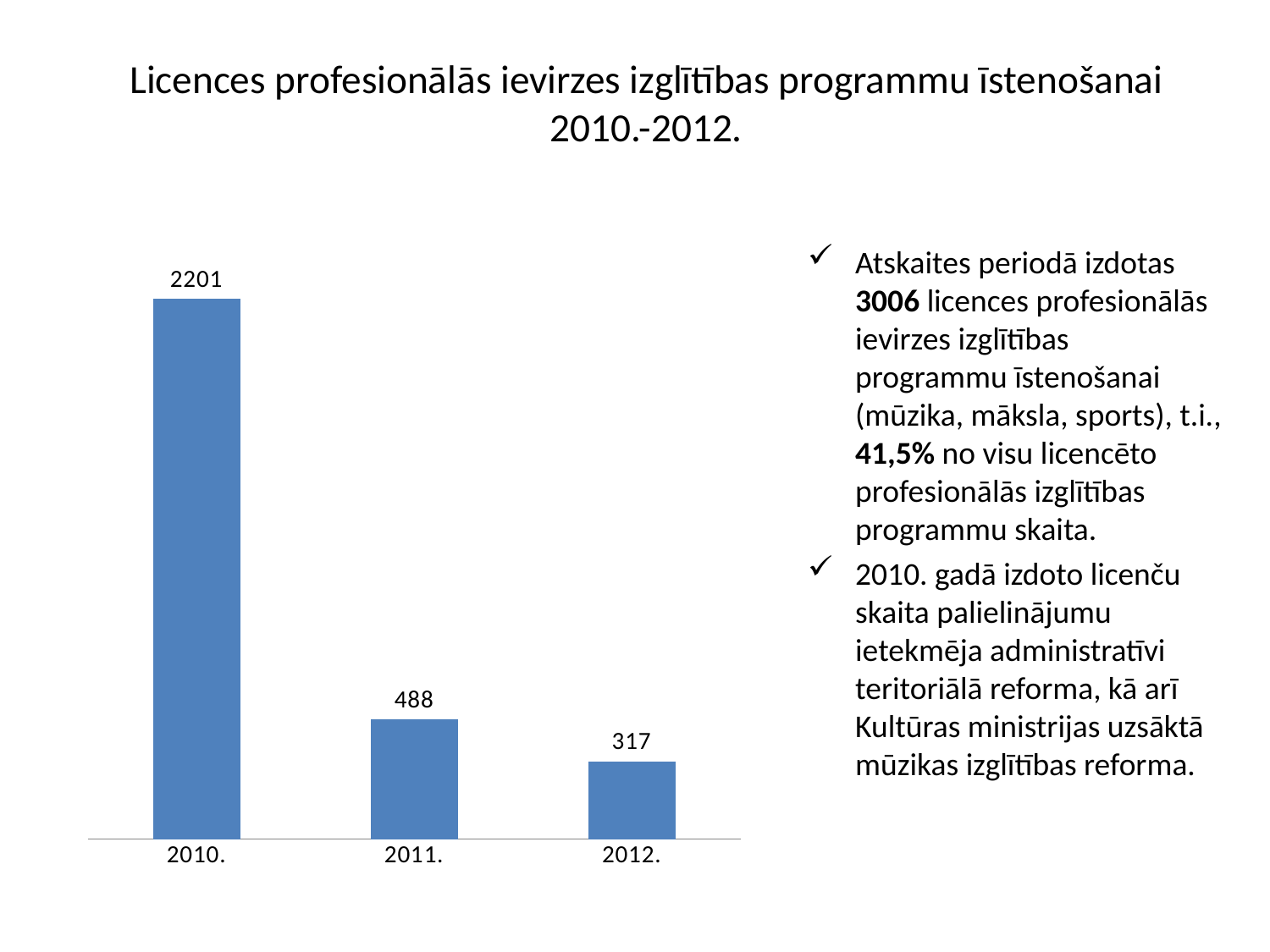
What is the difference between the values for 2011. and 2012.? 171 Which year has the lowest value? 2012. What is the value for 2010.? 2201 What is the difference between the values for 2010. and 2011.? 1713 What is the total of the three values shown on the chart? 3006 What is the value for 2012.? 317 Do the values rise or fall from 2010. to 2012.? fall Which is larger, the value for 2011. or the value for 2012.? 2011. How many years are shown on the chart? 3 Which year has the highest value? 2010. What kind of chart is shown on the slide? bar chart What is the value for 2011.? 488